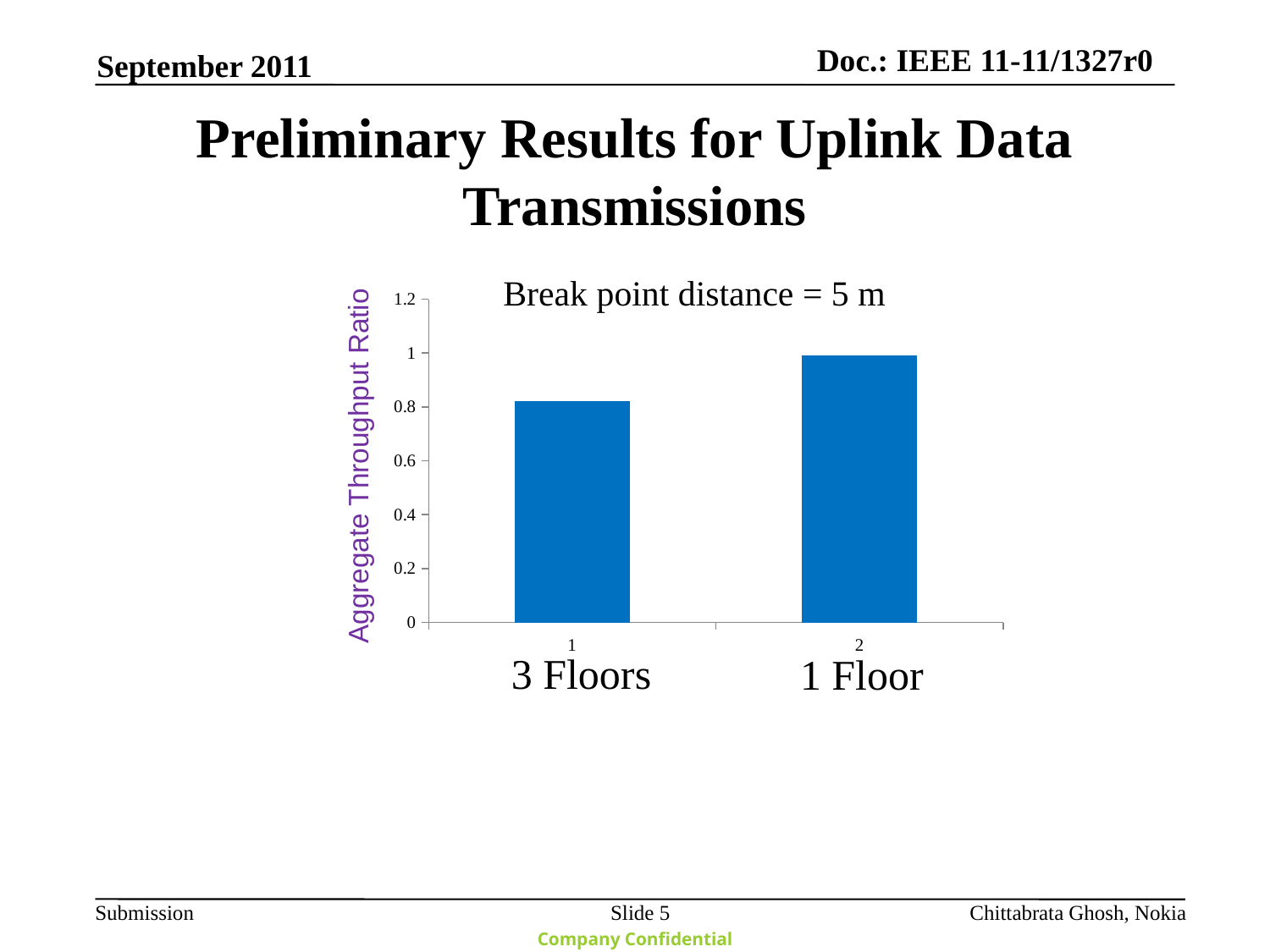
What kind of chart is shown on the slide? bar chart Is the value for 1 Floor greater or less than 1.2? less Is the value for 3 Floors greater or less than 1? less Is the value for 1 Floor greater or less than 0.8? greater What is the label on the vertical axis of the chart? Aggregate Throughput Ratio What is the title of the chart? Break point distance = 5 m Which is larger, the value for 3 Floors or the value for 1 Floor? 1 Floor Do the values rise or fall going from 3 Floors to 1 Floor along the x axis? rise How many bars are plotted in the chart? 2 Which category has the lowest Aggregate Throughput Ratio? 3 Floors Which category has the highest Aggregate Throughput Ratio? 1 Floor